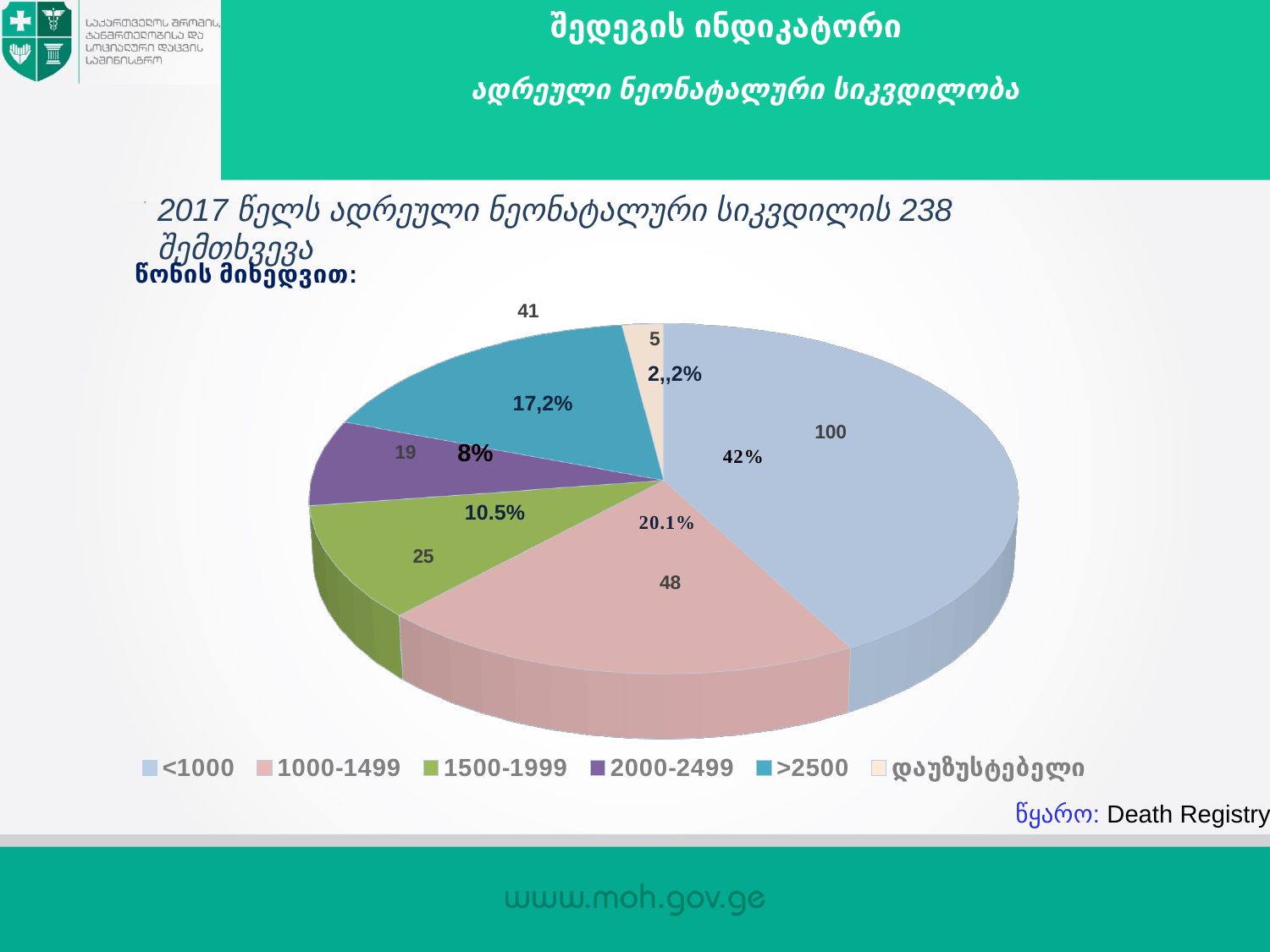
What is the value for the >2500 category? 41 Which category has the largest slice of the pie? <1000 What kind of chart is shown on the slide? pie chart Which is larger, the value for 1500-1999 or the value for >2500? >2500 What is the value for the <1000 category? 100 What is the value for the 1000-1499 category? 48 How many categories does the legend of the pie chart list? 6 What share of the pie does the 1000-1499 category represent? 20.1% Which category has the smallest slice of the pie? დაუზუსტებელი What is the value for the 2000-2499 category? 19 What is the difference between the values for <1000 and 1000-1499? 52 What source is cited for the chart data? Death Registry